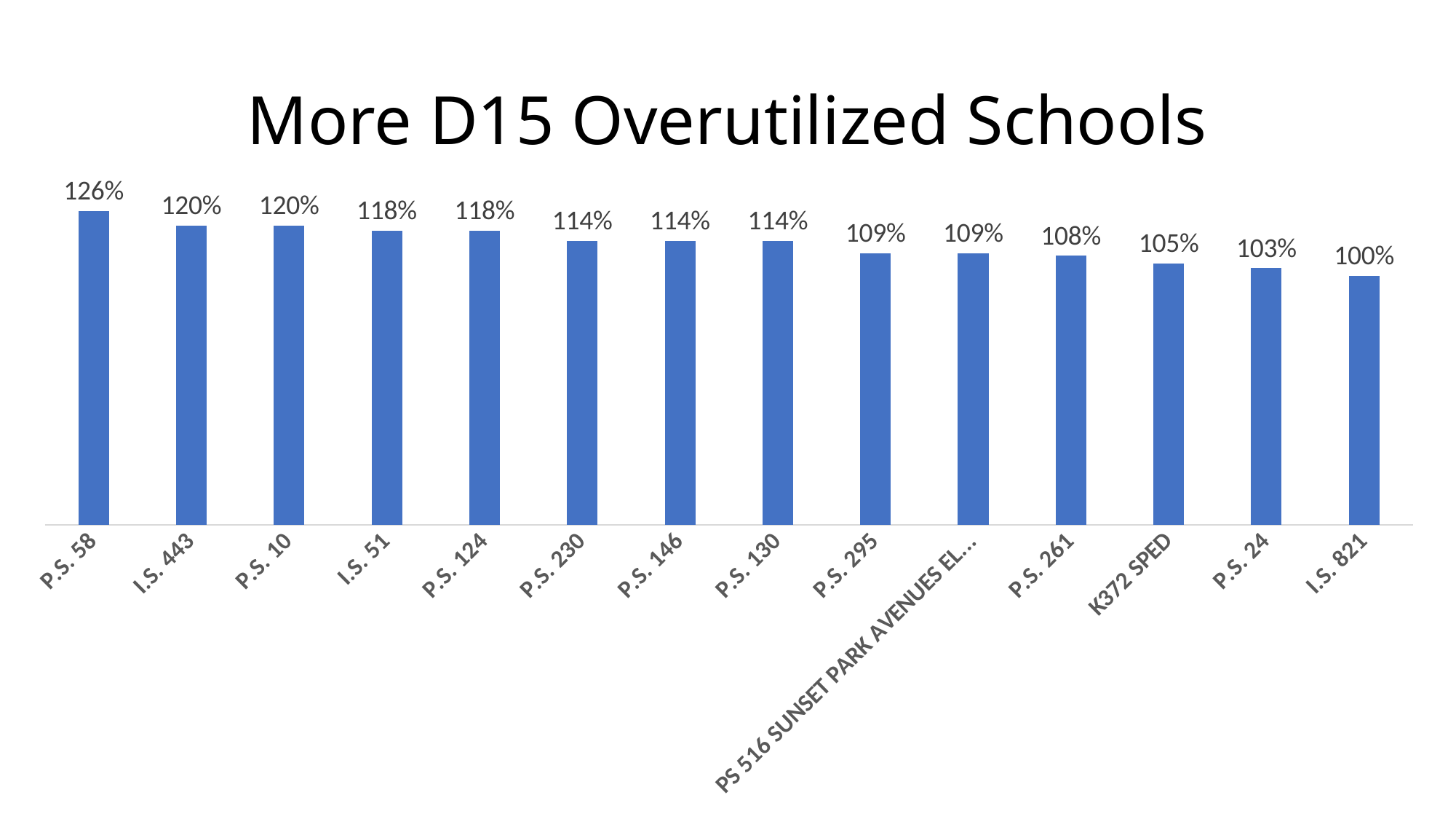
How many schools are shown in the chart? 14 What is the value for I.S. 51? 118% What is the title of the chart? More D15 Overutilized Schools What kind of chart is shown on the slide? Bar chart What is the difference between the values for I.S. 443 and P.S. 24? 17% Which school has the highest value? P.S. 58 Which is larger, the value for P.S. 230 or the value for P.S. 295? P.S. 230 What is the value for P.S. 261? 108% What is the difference between the values for P.S. 58 and I.S. 821? 26% What is the value for K372 SPED? 105% What is the value for P.S. 58? 126% Which school has the lowest value? I.S. 821